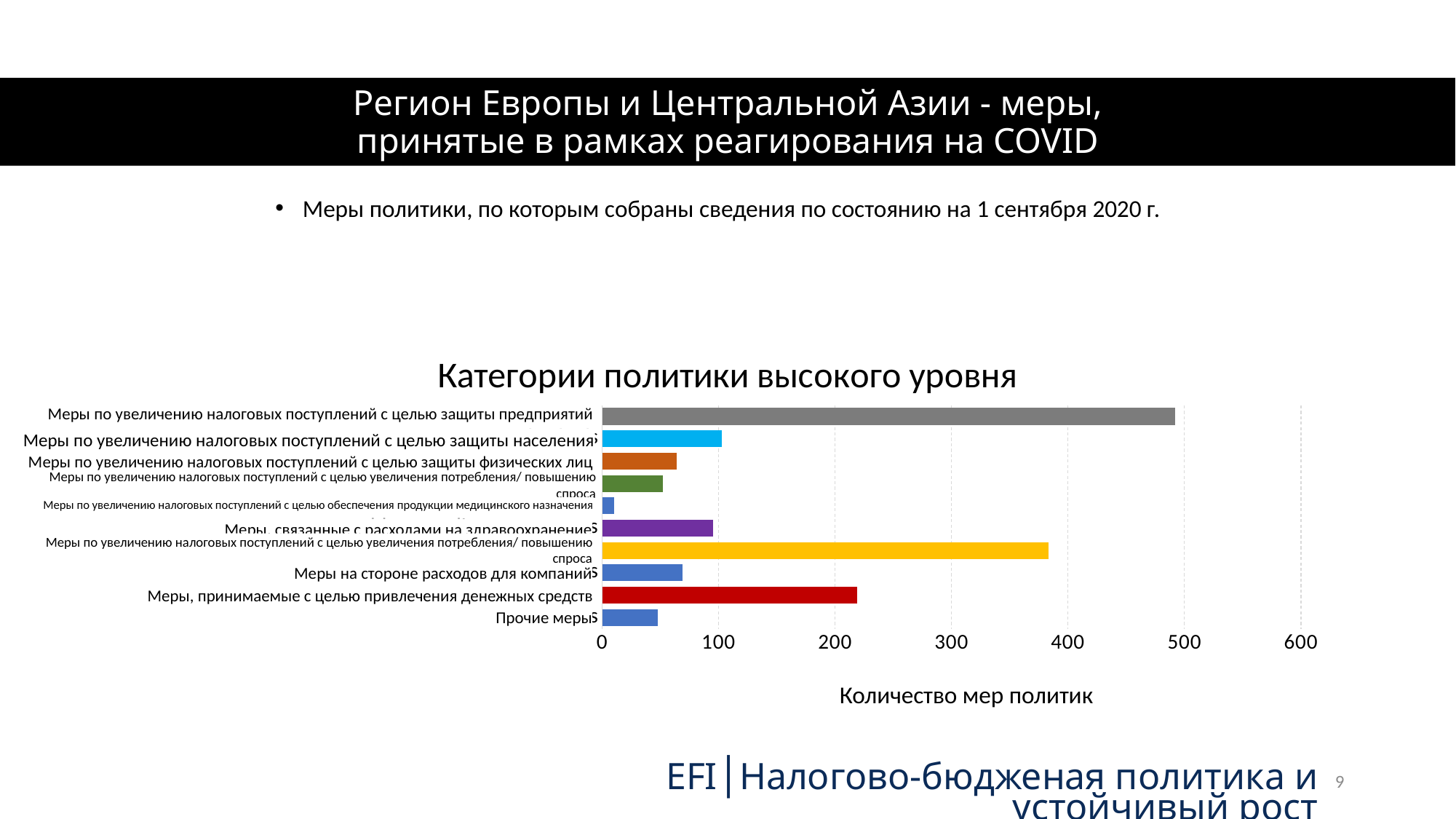
Is the value for 'Меры по увеличению налоговых поступлений с целью защиты предприятий' greater or less than 400? greater What is the label of the horizontal axis of the chart? Количество мер политик Which category has the lowest value? Меры по увеличению налоговых поступлений с целью обеспечения продукции медицинского назначения Is the value for 'Прочие меры' greater or less than 100? less What kind of chart is shown on the slide? Bar chart Which is larger: the value for 'Меры, принимаемые с целью привлечения денежных средств' or the value for 'Меры на стороне расходов для компаний'? Меры, принимаемые с целью привлечения денежных средств What is the title of the chart? Категории политики высокого уровня Which category has the highest value? Меры по увеличению налоговых поступлений с целью защиты предприятий Is the value for 'Меры, принимаемые с целью привлечения денежных средств' greater or less than 200? greater Which is larger: the value for 'Меры по увеличению налоговых поступлений с целью защиты населения' or the value for 'Прочие меры'? Меры по увеличению налоговых поступлений с целью защиты населения How many categories (bars) does the chart show? 10